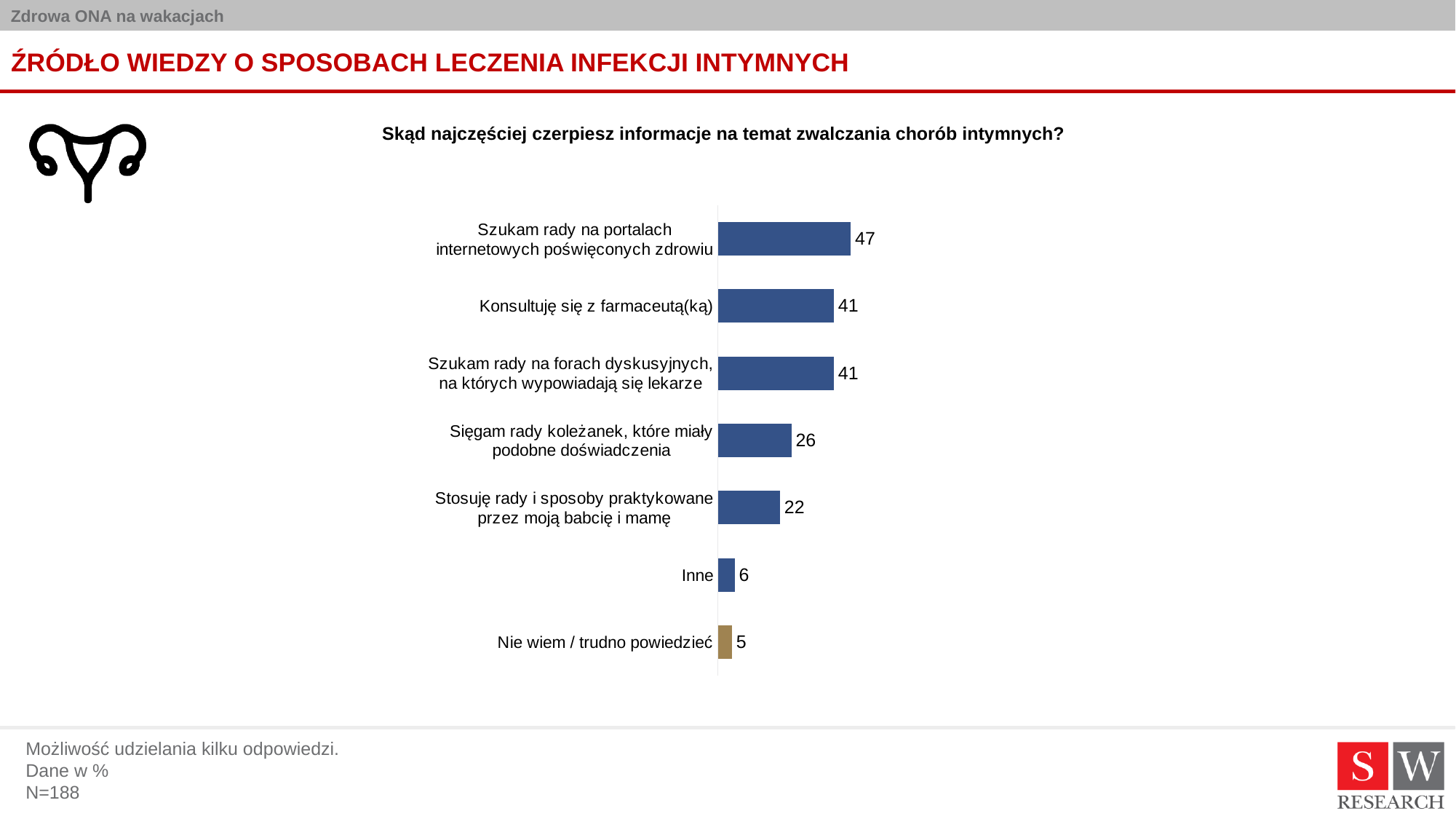
Which is larger: the value for "Sięgam rady koleżanek, które miały podobne doświadczenia" or for "Stosuję rady i sposoby praktykowane przez moją babcię i mamę"? Sięgam rady koleżanek, które miały podobne doświadczenia What is the value for "Szukam rady na portalach internetowych poświęconych zdrowiu"? 47 What is the difference between the values for "Szukam rady na portalach internetowych poświęconych zdrowiu" and "Konsultuję się z farmaceutą(ką)"? 6 How many categories are shown in the chart? 7 What is the value for "Stosuję rady i sposoby praktykowane przez moją babcię i mamę"? 22 What is the value for "Konsultuję się z farmaceutą(ką)"? 41 What kind of chart is shown on the slide? Bar chart Which category has the lowest value? Nie wiem / trudno powiedzieć Which bar is shown in a different colour (brown) from the others? Nie wiem / trudno powiedzieć What is the value for "Sięgam rady koleżanek, które miały podobne doświadczenia"? 26 What is the value for "Inne"? 6 Which category has the highest value? Szukam rady na portalach internetowych poświęconych zdrowiu